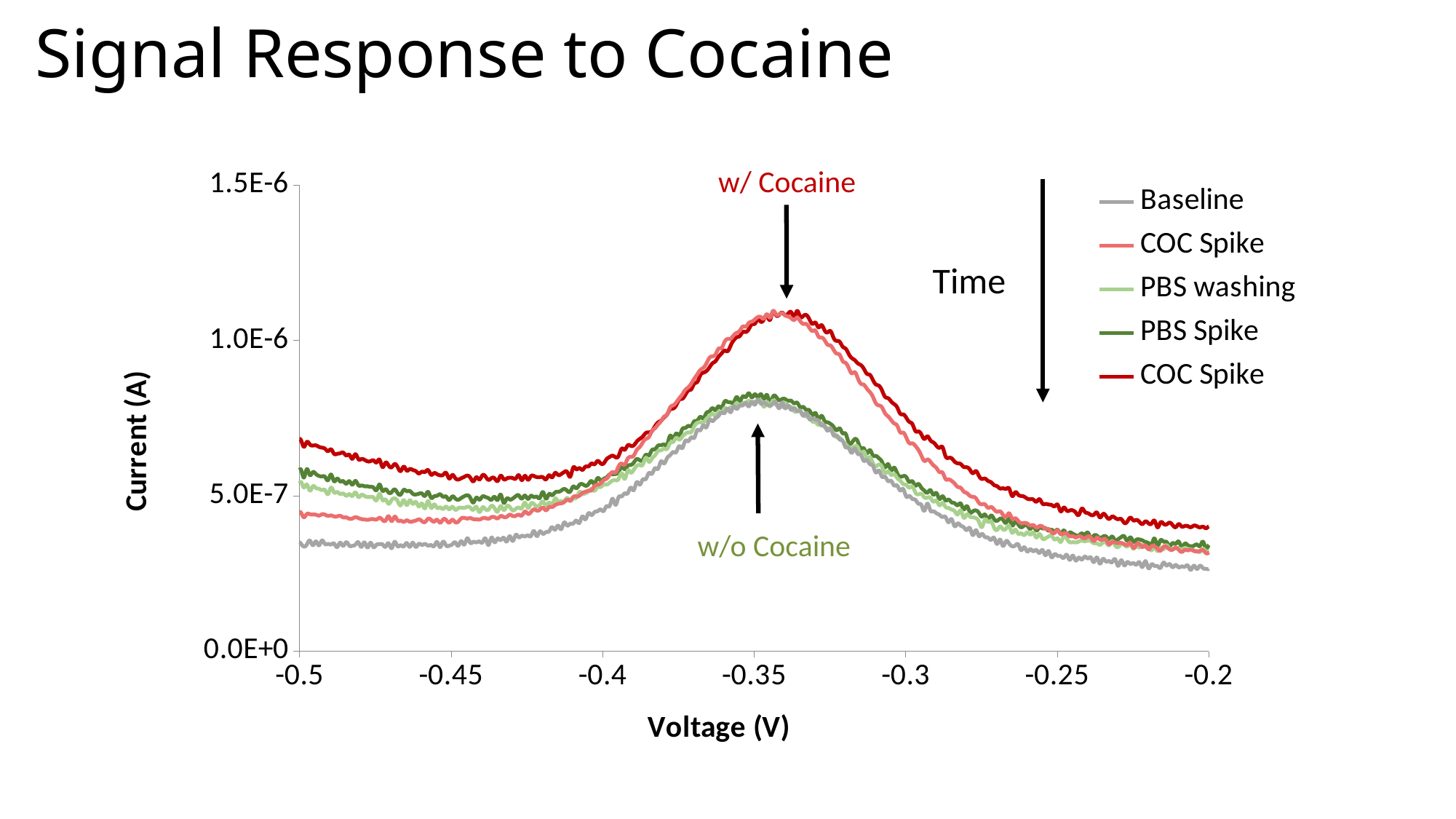
How many series does the legend list? 5 Which series has the lowest current at -0.2 V? Baseline What is the title of the chart on the slide? Signal Response to Cocaine Does the Baseline current rise or fall as voltage goes from -0.5 V to -0.35 V? Rise Is the dark red COC Spike value at -0.5 V greater or less than 5.0E-7? greater What is the label of the y axis? Current (A) At -0.35 V, which is higher: the COC Spike lines or the Baseline line? COC Spike Is the peak value of the Baseline line greater or less than 1.0E-6? less What kind of chart is shown on the slide? Line chart Is the Baseline value at -0.5 V greater or less than 5.0E-7? less Does the Baseline current rise or fall as voltage goes from -0.35 V to -0.2 V? Fall